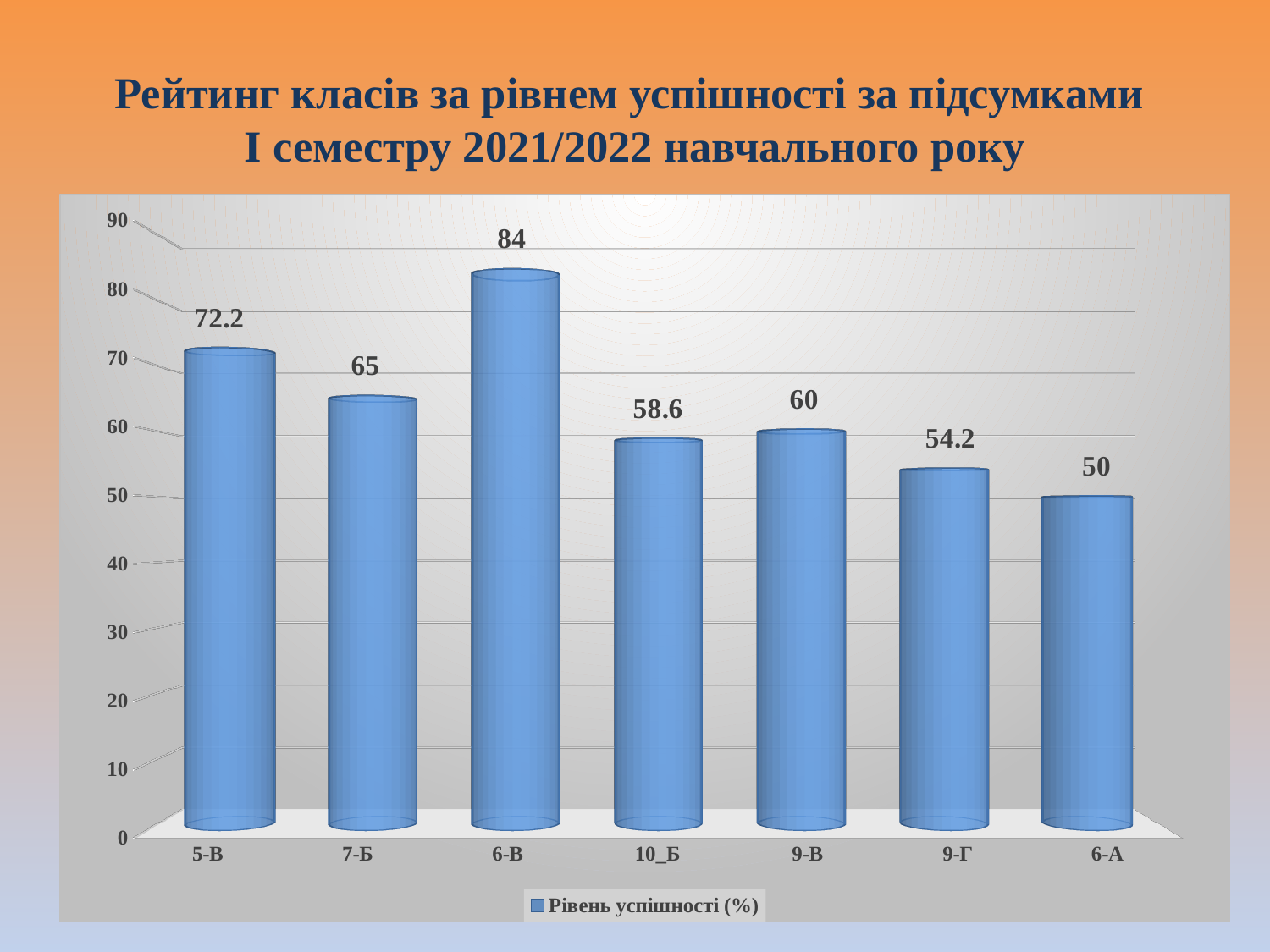
Is the value for 7-Б greater or less than 70? less What is the value for 5-В? 72.2 What is the difference between the values for 6-В and 6-А? 34 Which class has the highest value? 6-В Which is larger, the value for 9-В or the value for 10_Б? 9-В Which class has the lowest value? 6-А What is the difference between the values for 5-В and 7-Б? 7.2 How many classes are shown on the x axis? 7 How many series does the legend list? 1 What is the value for 10_Б? 58.6 What is the value for 9-Г? 54.2 What kind of chart is shown? bar chart